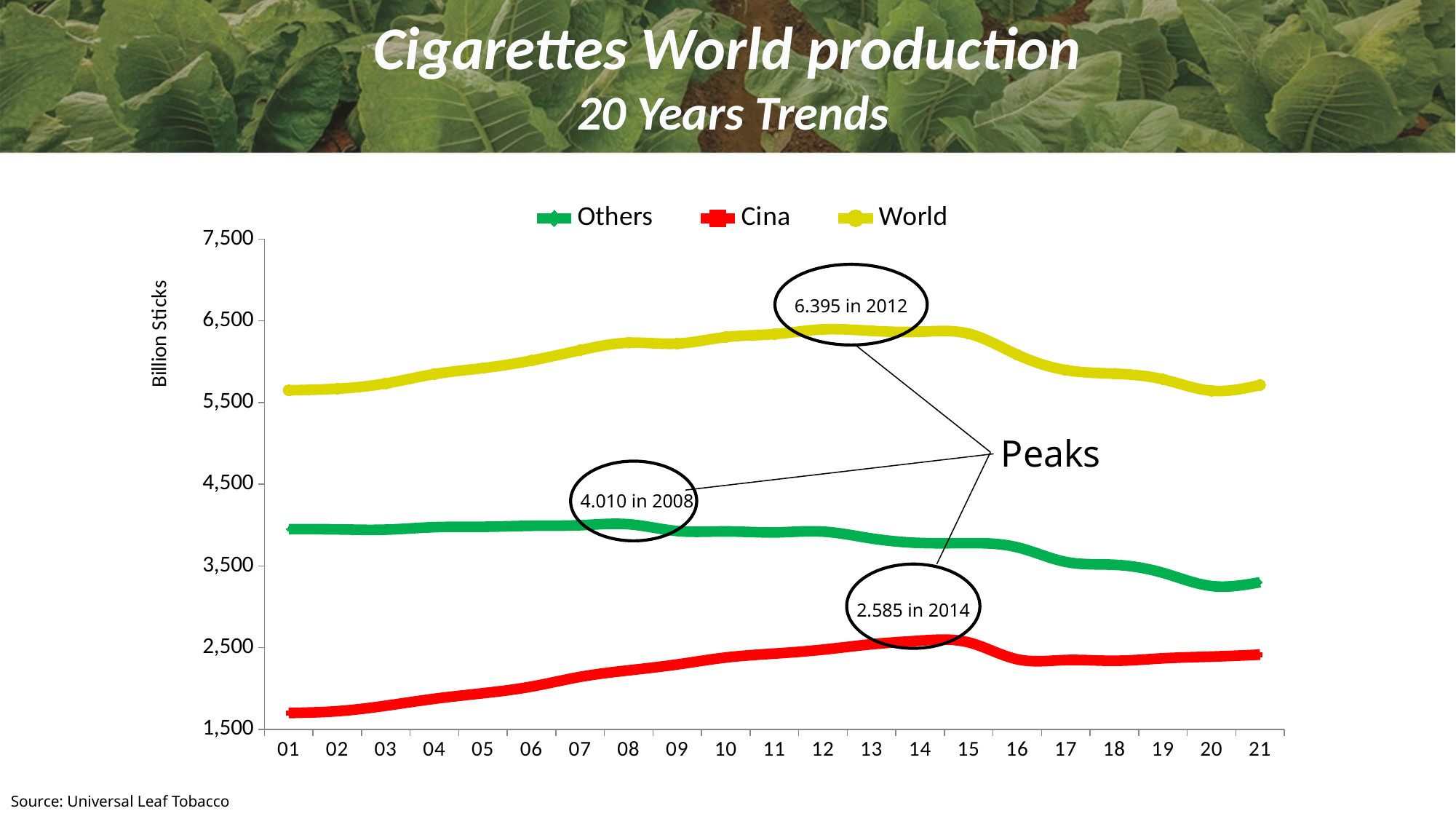
What is the peak value annotated for the World series? 6.395 in 2012 How many years are plotted along the x axis? 21 Is the value for Cina in 01 greater or less than 2,500? less Is the value for World in 21 greater or less than 5,500? greater What kind of chart is shown on the slide? line chart In which year did the Cina series reach its peak? 2014 What is the peak value annotated for the Cina series? 2.585 in 2014 How many series does the legend list? 3 What is the peak value annotated for the Others series? 4.010 in 2008 What is the label on the y axis? Billion Sticks Does the Cina series rise or fall from 01 to 14? rise Which series has the highest values across the whole chart? World